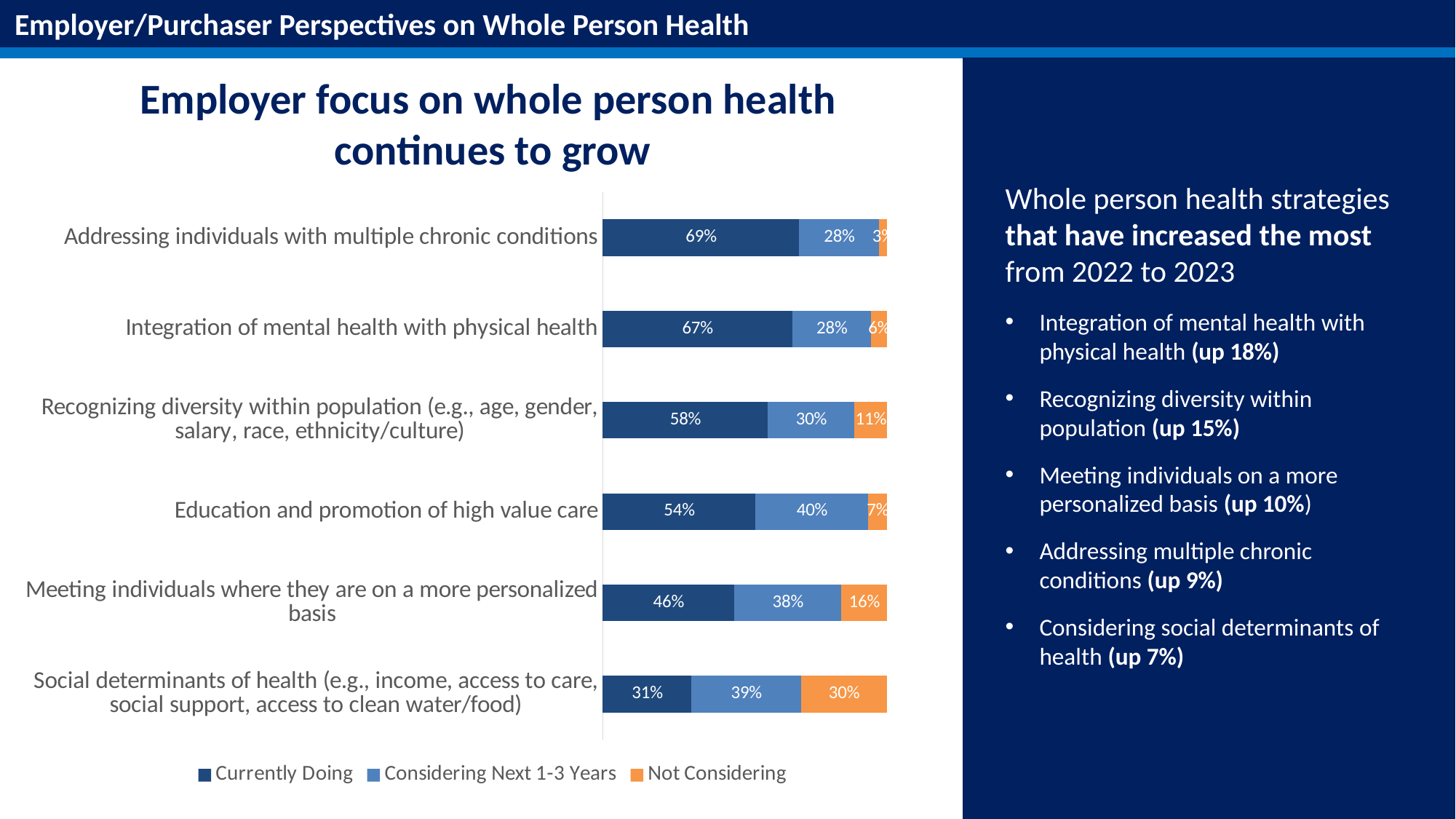
What type of chart is shown on the slide? Stacked bar chart What percentage of employers are considering 'Education and promotion of high value care' in the next 1-3 years? 40% What percentage of employers are currently doing 'Integration of mental health with physical health'? 67% Which category has the highest 'Currently Doing' percentage? Addressing individuals with multiple chronic conditions What percentage of employers are not considering 'Social determinants of health'? 30% What is the title of the chart? Employer focus on whole person health continues to grow What is the difference between the 'Currently Doing' percentages for 'Addressing individuals with multiple chronic conditions' and 'Social determinants of health'? 38% How many series does the legend list? 3 Which category has the highest 'Not Considering' percentage? Social determinants of health Which category has the lowest 'Currently Doing' percentage? Social determinants of health Which is larger: the 'Not Considering' value for 'Meeting individuals where they are on a more personalized basis' or for 'Recognizing diversity within population'? Meeting individuals where they are on a more personalized basis How many categories are shown in the chart? 6